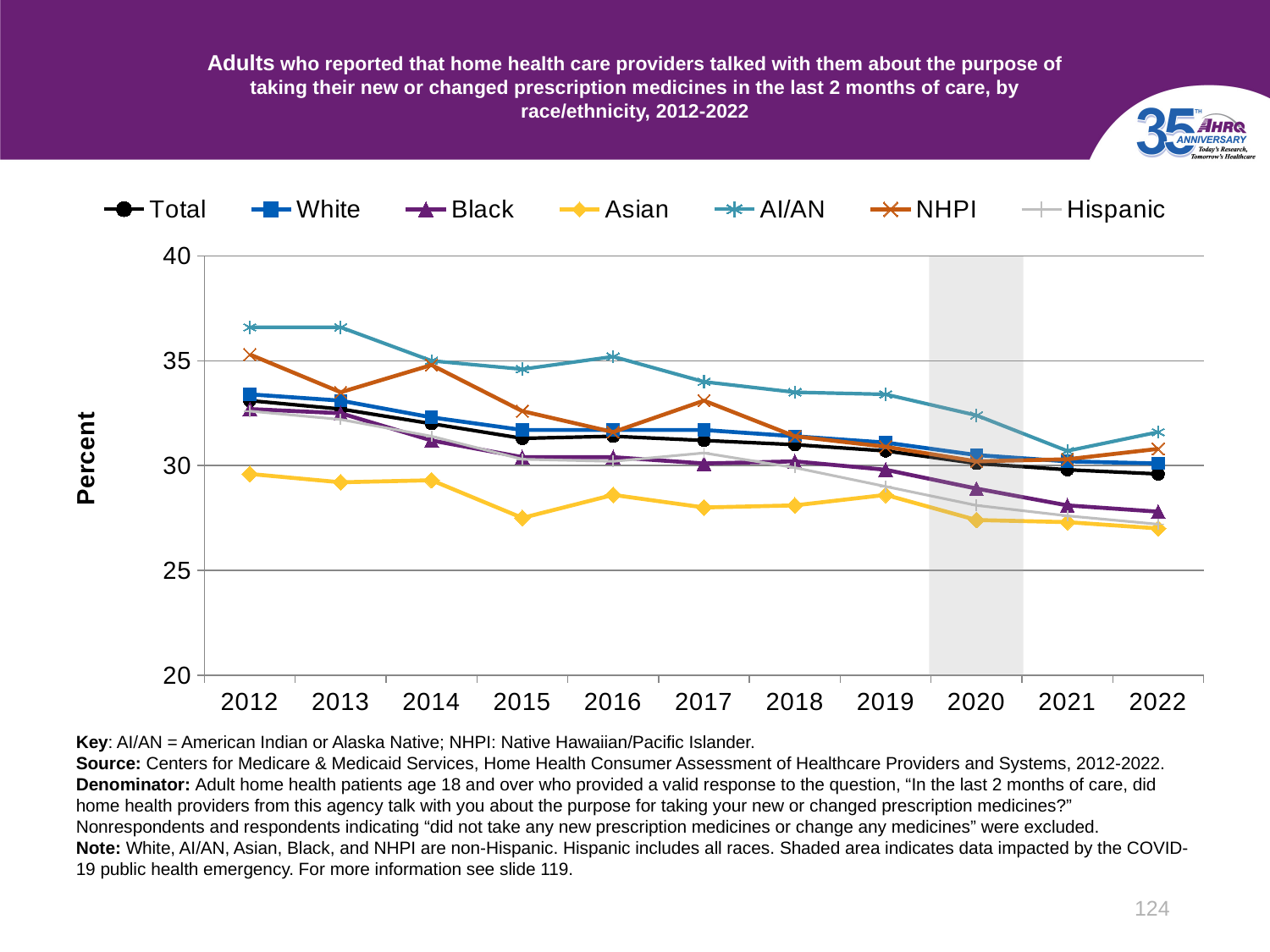
Which race/ethnicity group had the highest value in 2012? AI/AN In 2014, which is larger: the value for NHPI or the value for Asian? NHPI Which race/ethnicity group had the lowest value in 2012? Asian Does the Total line rise or fall from 2012 to 2022? fall Is the value for Black in 2022 greater or less than 30? less How many years are plotted along the x axis? 11 How many series does the legend list? 7 In 2016, which is larger: the value for AI/AN or the value for Asian? AI/AN What kind of chart is shown on the slide? line chart Is the value for Asian in 2015 greater or less than 30? less What is the label on the y axis? Percent Is the value for AI/AN in 2012 greater or less than 35? greater